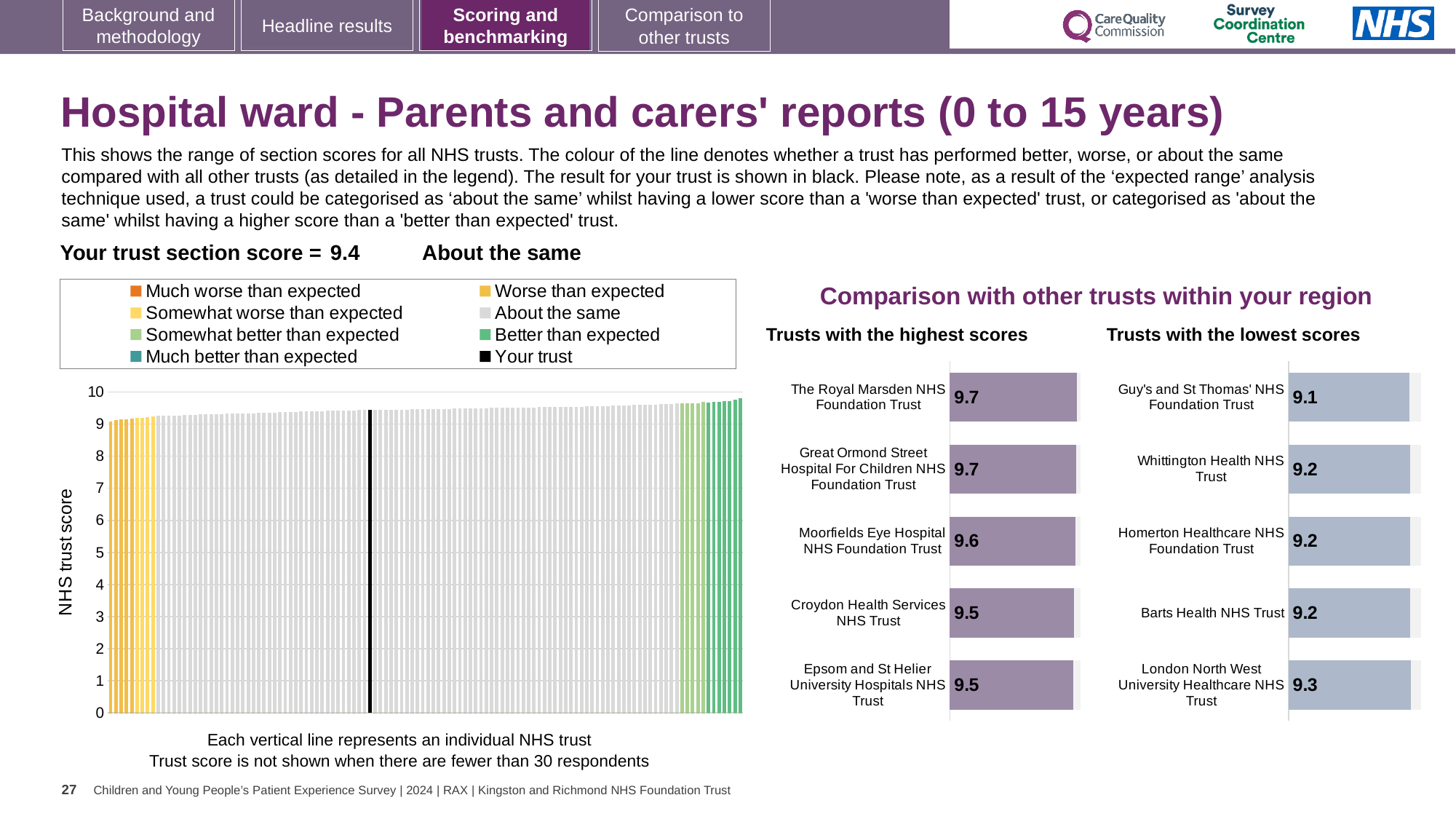
How many entries does the legend of the main chart on the left list? 8 In the main chart on the left, what is the section score for your trust (the black line)? 9.4 In the 'Trusts with the highest scores' chart, which has the larger score: Moorfields Eye Hospital NHS Foundation Trust or Croydon Health Services NHS Trust? Moorfields Eye Hospital NHS Foundation Trust In the 'Trusts with the lowest scores' chart, which trust has the lowest score? Guy's and St Thomas' NHS Foundation Trust In the main chart on the left, are the values for the 'Worse than expected' trusts greater or less than 5? greater What kind of chart is the main chart on the left of the slide? Bar chart In the 'Trusts with the highest scores' chart, what is the difference between the scores of The Royal Marsden NHS Foundation Trust and Epsom and St Helier University Hospitals NHS Trust? 0.2 In the 'Trusts with the lowest scores' chart, what is the score for Guy's and St Thomas' NHS Foundation Trust? 9.1 How many trusts are shown in the 'Trusts with the lowest scores' chart? 5 In the 'Trusts with the highest scores' chart, what is the score for The Royal Marsden NHS Foundation Trust? 9.7 In the 'Trusts with the highest scores' chart, what is the score for Moorfields Eye Hospital NHS Foundation Trust? 9.6 In the 'Trusts with the lowest scores' chart, which trust has the highest score? London North West University Healthcare NHS Trust